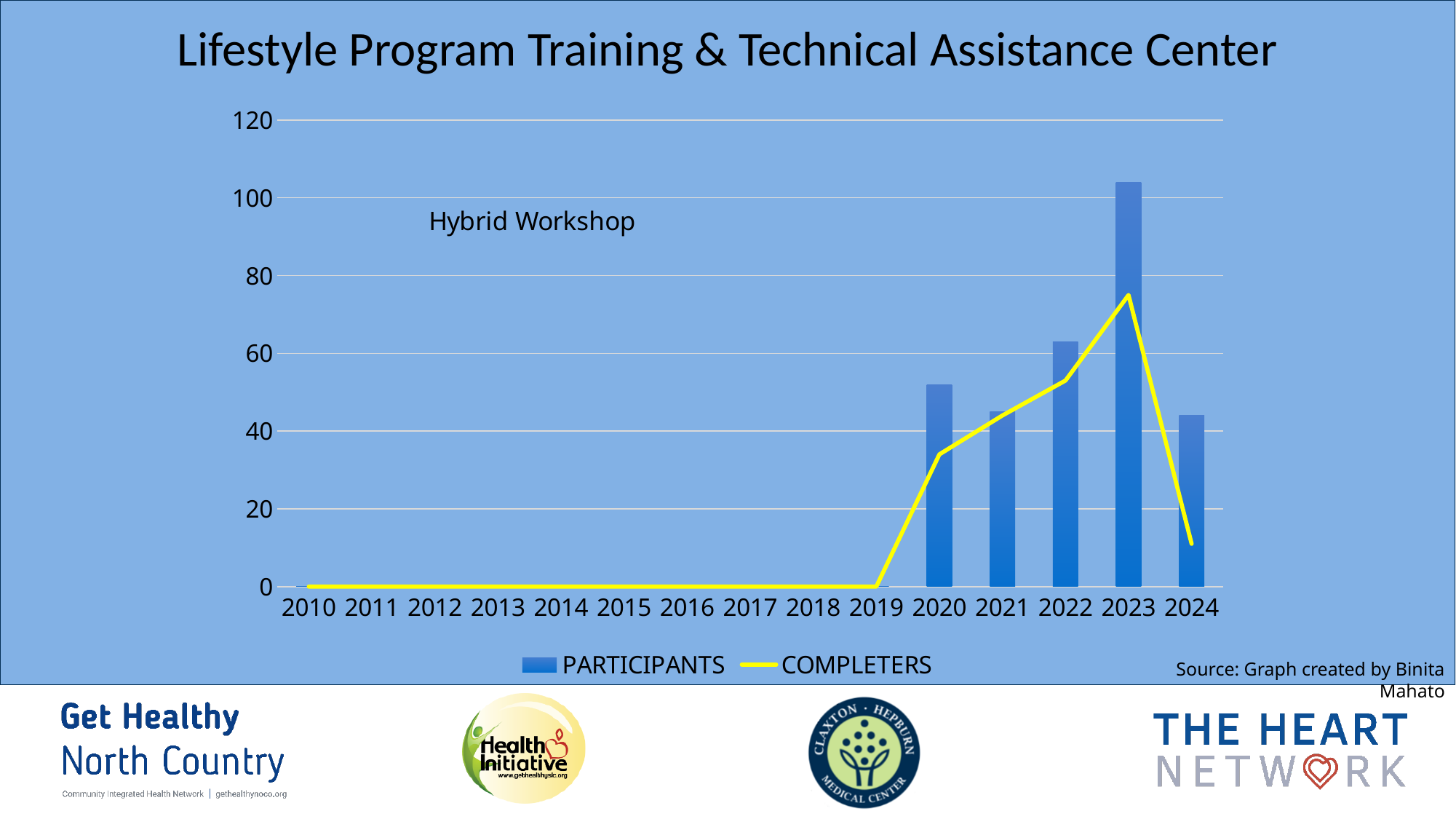
Does the COMPLETERS line rise or fall from 2020 to 2023? rise In which year is the PARTICIPANTS bar the highest? 2023 How many series does the legend list? 2 What text annotation appears inside the plot area of the chart? Hybrid Workshop What kind of chart is shown on the slide? A combined bar and line chart Is the COMPLETERS value for 2024 greater or less than 20? less Is the PARTICIPANTS value for 2020 greater or less than 40? greater How many years are shown along the x axis? 15 Is the PARTICIPANTS value for 2023 greater or less than 100? greater Does the PARTICIPANTS value rise or fall from 2023 to 2024? fall Which year has more PARTICIPANTS, 2021 or 2022? 2022 In which year does the COMPLETERS line reach its highest point? 2023